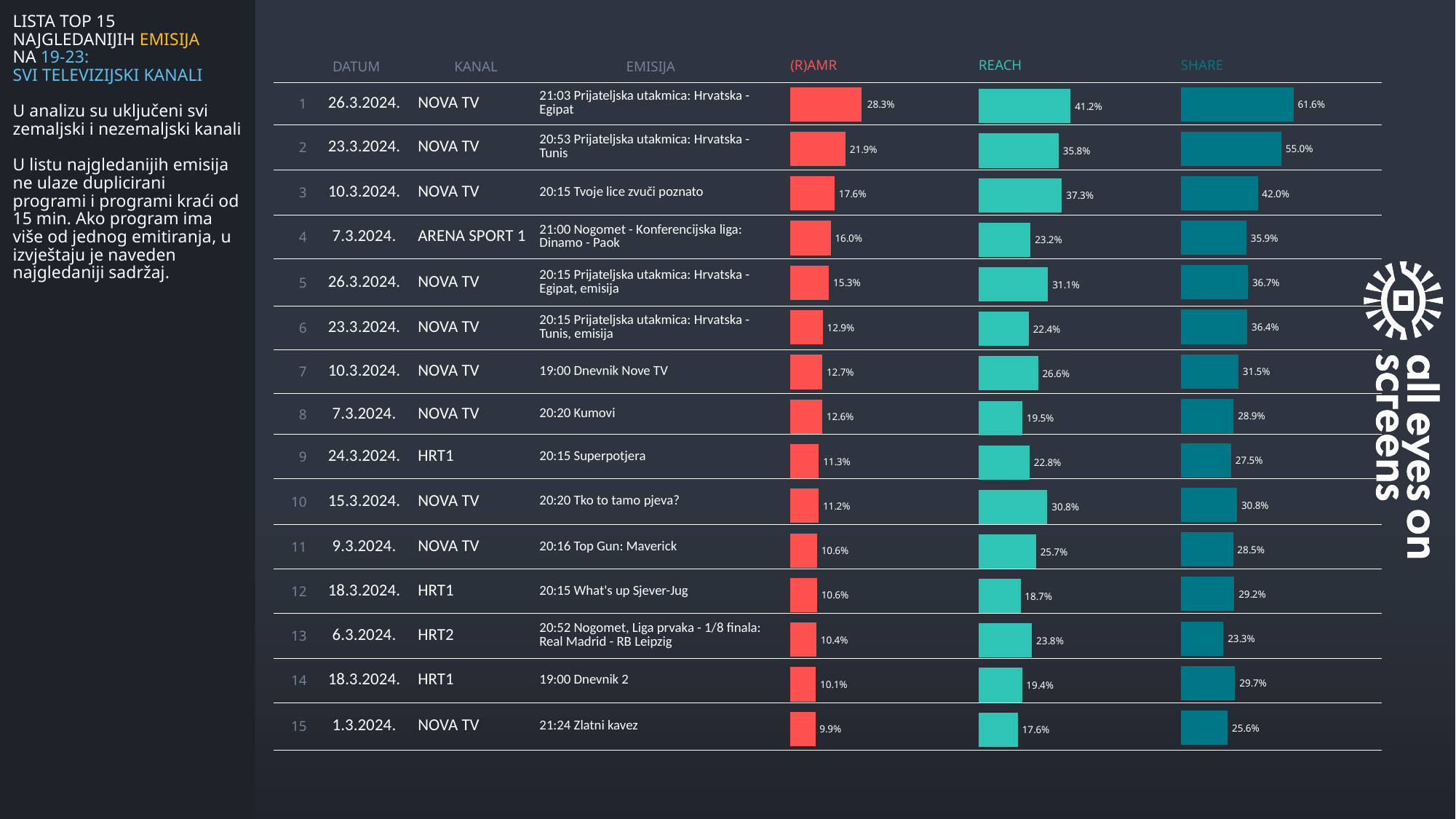
In the SHARE column, which programme has the lowest value? 20:52 Nogomet, Liga prvaka - 1/8 finala: Real Madrid - RB Leipzig In the SHARE column, which programme has the highest value? 21:03 Prijateljska utakmica: Hrvatska - Egipat What kind of chart is used to display the (R)AMR, REACH and SHARE values? Bar chart In the REACH column, which programme has the lowest value? 21:24 Zlatni kavez How many programmes are listed in the table? 15 In the REACH column, what is the value for '20:20 Kumovi'? 19.5% In the SHARE column, what is the value for '21:00 Nogomet - Konferencijska liga: Dinamo - Paok'? 35.9% In the (R)AMR column, what is the value for the programme '20:15 Tvoje lice zvuči poznato'? 17.6% In the REACH column, which is larger: '20:15 Superpotjera' or '20:20 Tko to tamo pjeva?'? 20:20 Tko to tamo pjeva? In the SHARE column, what is the difference between '20:15 Tvoje lice zvuči poznato' and '19:00 Dnevnik Nove TV'? 10.5% What colour are the bars in the (R)AMR column? Red In the (R)AMR column, what is the difference between '21:03 Prijateljska utakmica: Hrvatska - Egipat' and '20:53 Prijateljska utakmica: Hrvatska - Tunis'? 6.4%